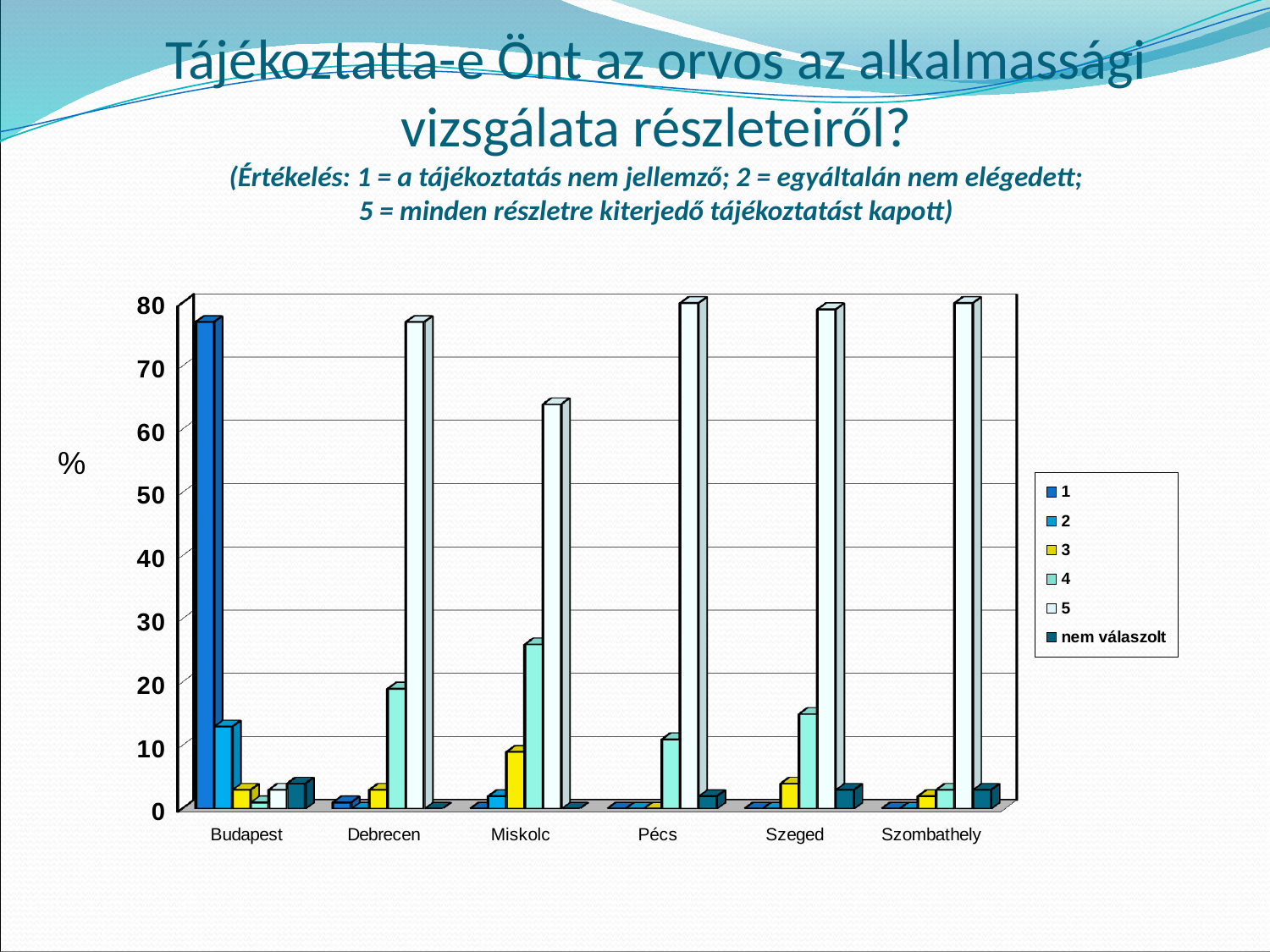
Which city has the lowest value for series 5? Budapest Which is larger: the value for series 5 in Pécs or the value for series 5 in Miskolc? Pécs Is the value for series 4 in Debrecen greater or less than 10? greater Is the value for series 5 in Miskolc greater or less than 70? less Which city has the highest value for series 1? Budapest Which is larger in Miskolc: the value for series 4 or the value for series 3? series 4 How many cities (categories) are shown on the x axis of the chart? 6 What is the label of the last entry in the chart's legend? nem válaszolt How many series does the chart's legend list? 6 Is the value for series 4 in Miskolc greater or less than 20? greater What kind of chart is shown on the slide? bar chart